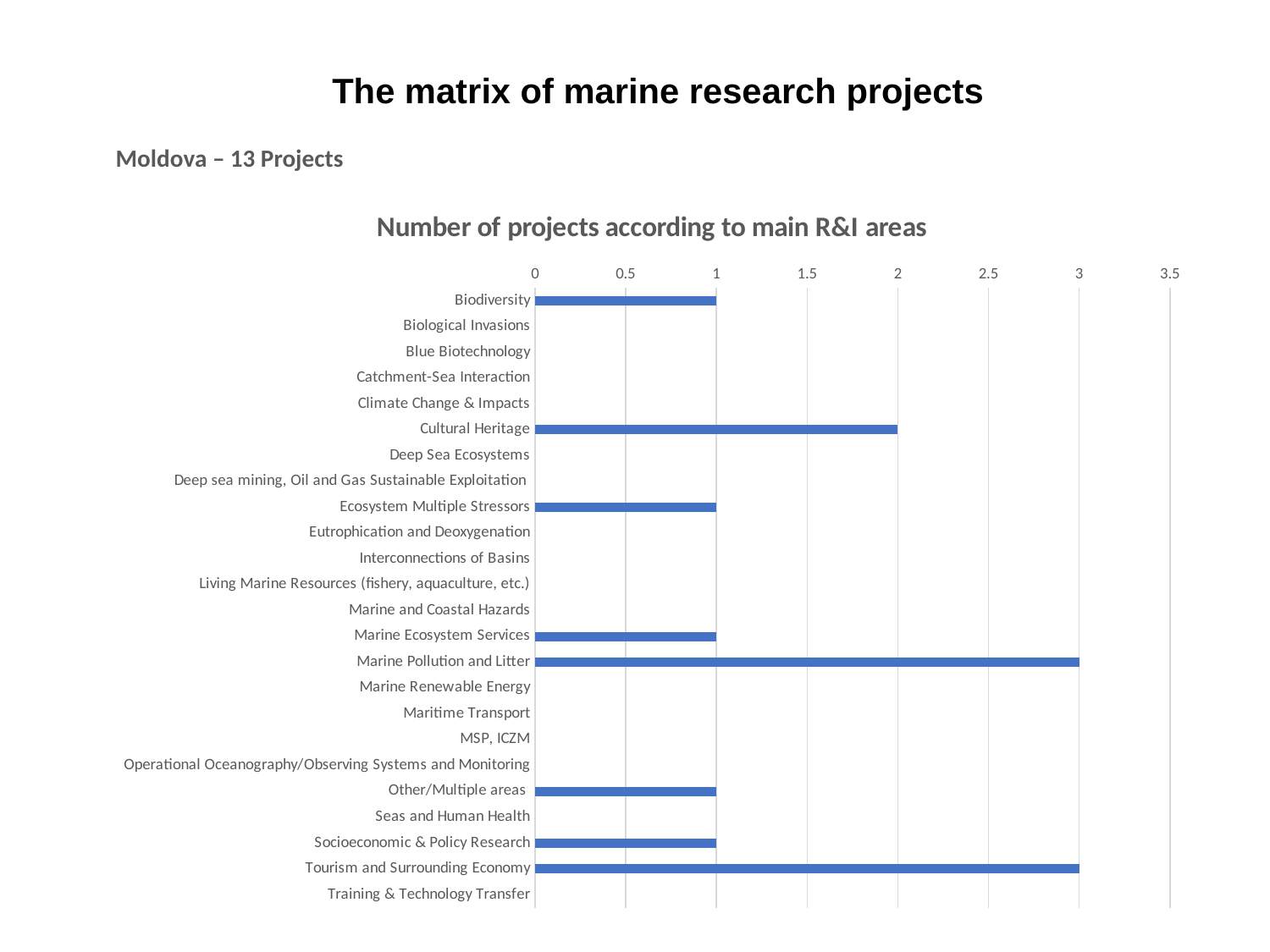
How many projects are shown for Biodiversity? 1 How many projects are shown for Marine Pollution and Litter? 3 How many categories have a bar showing at least one project? 8 How many projects are shown for Tourism and Surrounding Economy? 3 How many R&I area categories are listed on the chart's vertical axis? 24 How many projects are shown for Socioeconomic & Policy Research? 1 What is the title of the chart? Number of projects according to main R&I areas Which has more projects, Cultural Heritage or Ecosystem Multiple Stressors? Cultural Heritage Is the value for Cultural Heritage greater or less than 1.5? greater How many projects are shown for Cultural Heritage? 2 What is the difference between the number of projects for Marine Pollution and Litter and for Cultural Heritage? 1 What type of chart is shown on the slide? bar chart